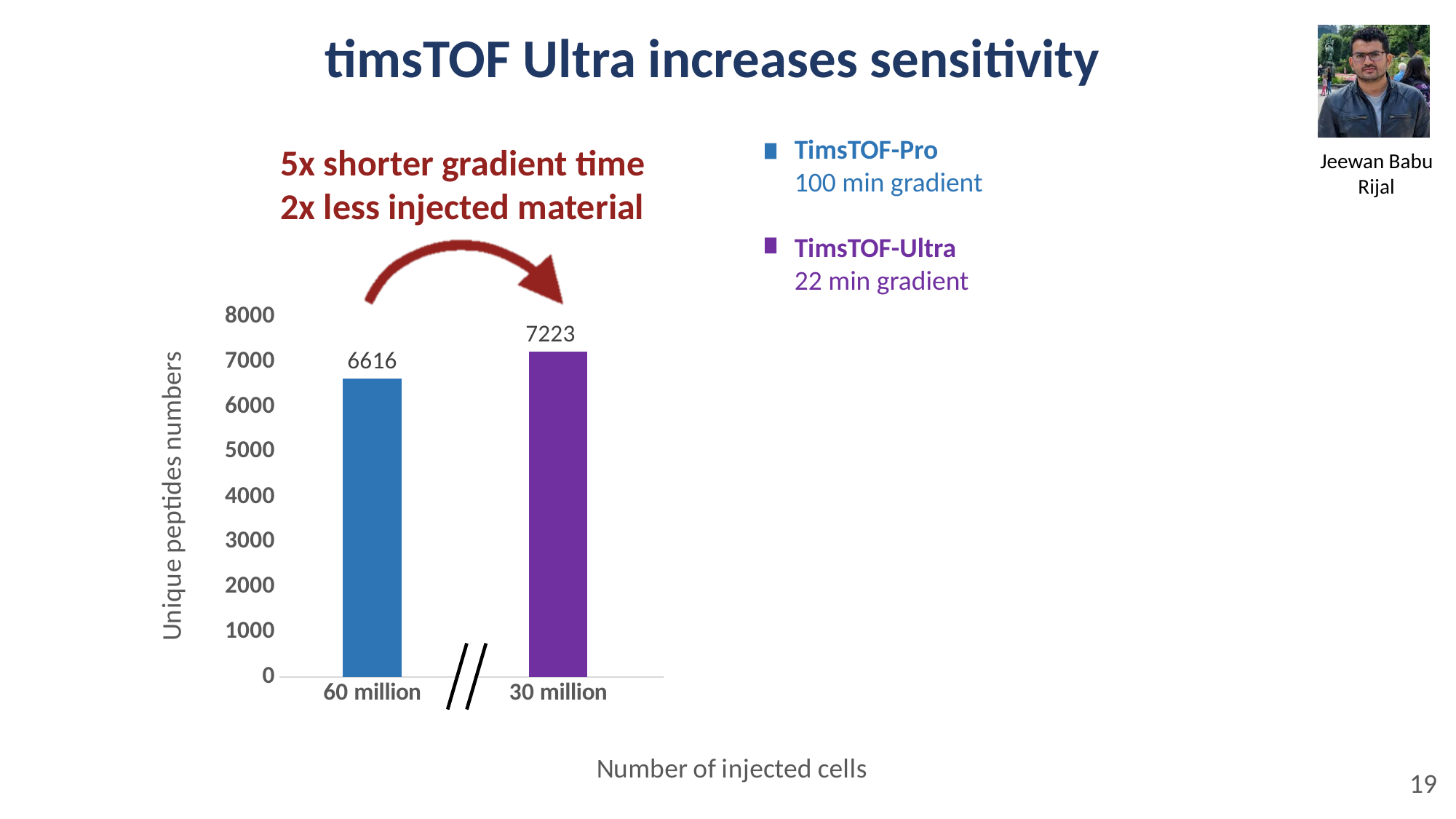
Which category has the lower number of unique peptides? 60 million What kind of chart is shown on the slide? bar chart Which instrument does the purple bar represent according to the legend? TimsTOF-Ultra Is the value for 30 million greater or less than 7000? greater Is the value for 60 million greater or less than 7000? less What is the label of the x axis? Number of injected cells How many bars are plotted in the chart? 2 What is the difference in unique peptide numbers between 30 million and 60 million injected cells? 607 What is the number of unique peptides for 30 million injected cells? 7223 Which category has the higher number of unique peptides? 30 million What is the label of the y axis? Unique peptides numbers What is the number of unique peptides for 60 million injected cells? 6616